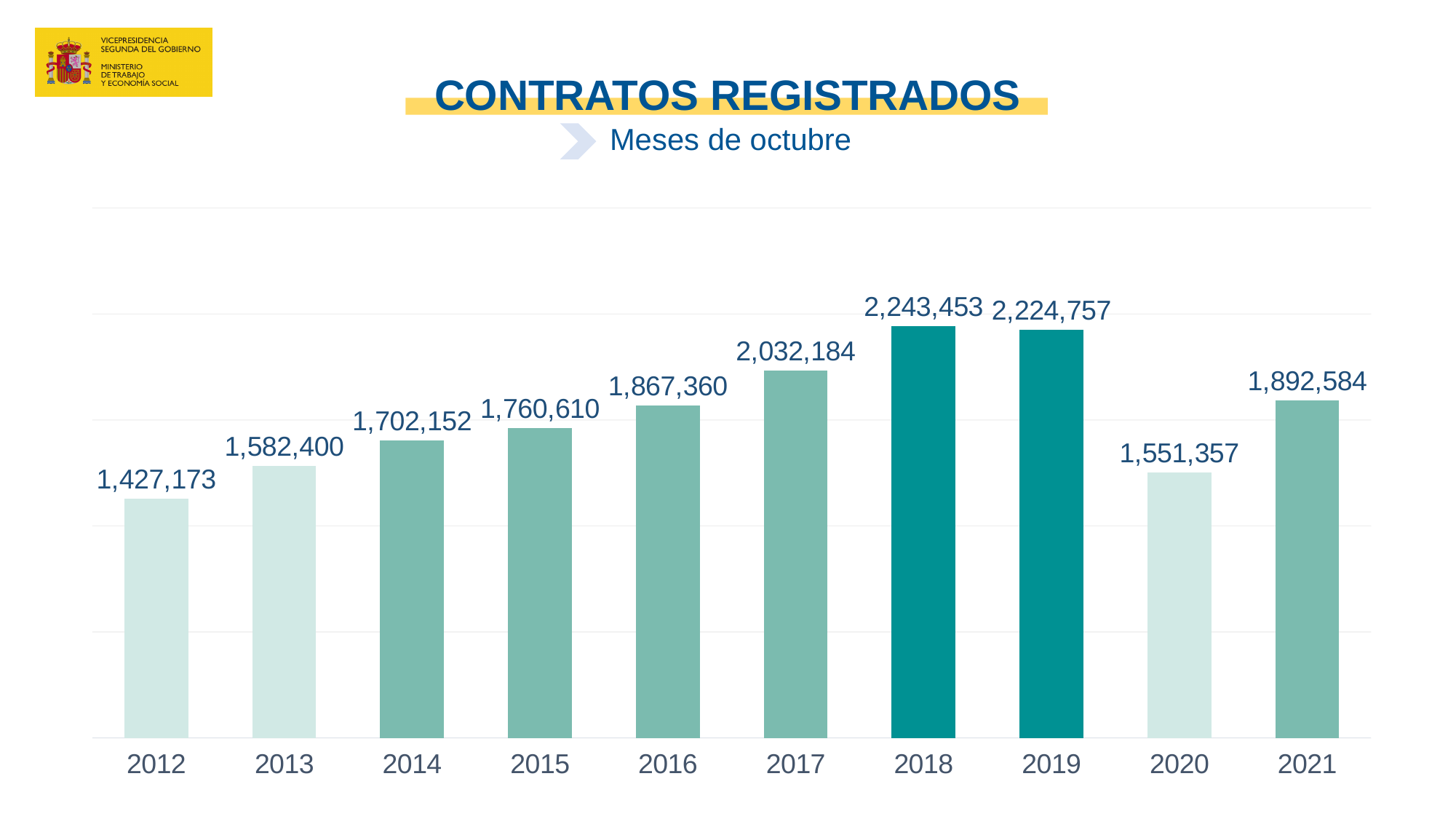
What kind of chart is shown on the slide? Bar chart What is the number of registered contracts for October 2018? 2,243,453 Which year has the highest number of registered contracts? 2018 What is the difference between the values for 2018 and 2019? 18,696 What is the number of registered contracts for October 2020? 1,551,357 What is the title of the chart? CONTRATOS REGISTRADOS Which year has the lowest number of registered contracts? 2012 How many years are shown on the chart? 10 What is the number of registered contracts for October 2012? 1,427,173 What is the difference between the values for 2021 and 2020? 341,227 Which year has a larger value, 2017 or 2016? 2017 What is the number of registered contracts for October 2021? 1,892,584